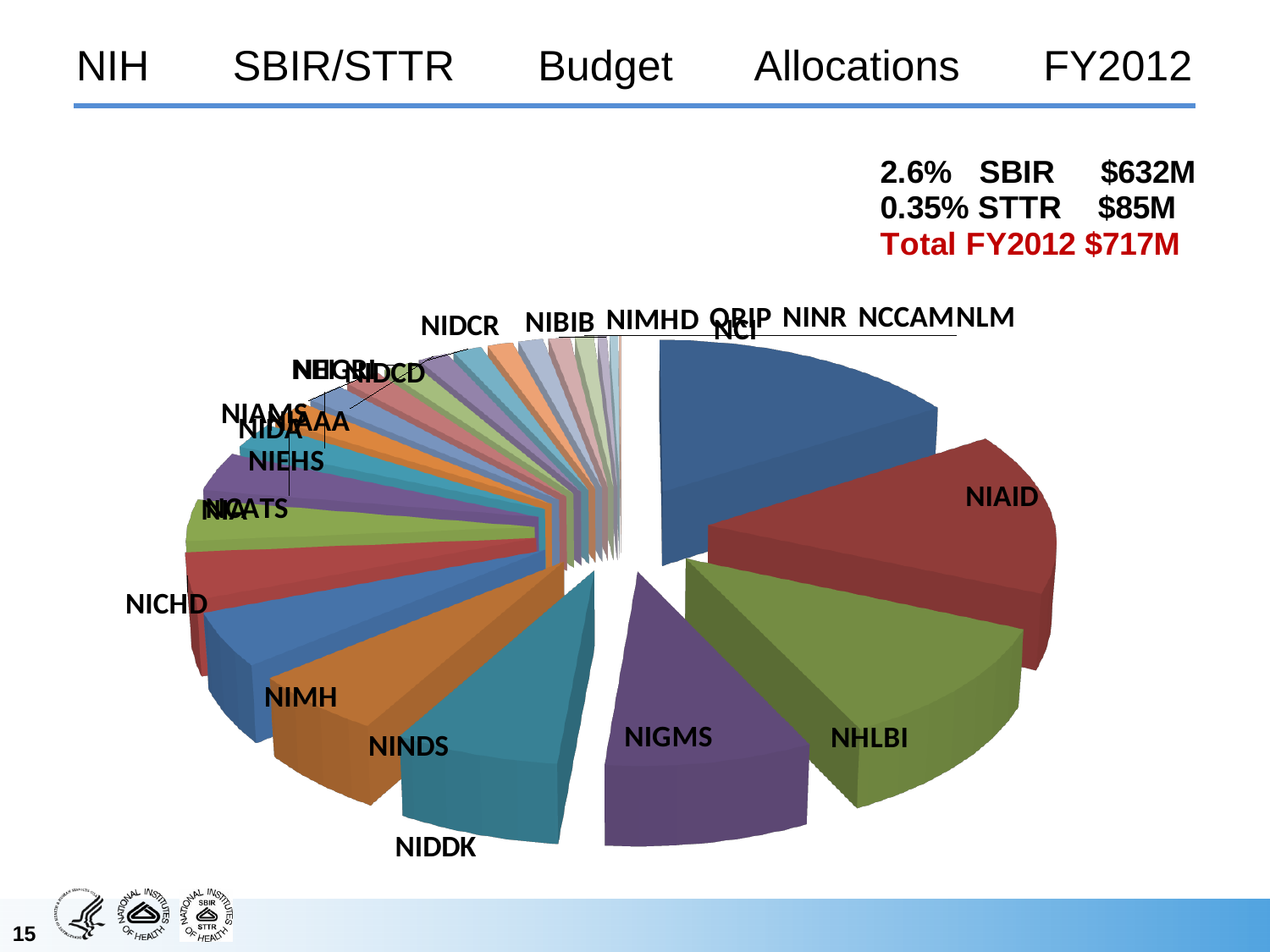
Which slice is larger, NHLBI or NINR? NHLBI What kind of chart is shown on the slide? pie chart According to the text beside the pie chart, what is the total FY2012 budget? $717M What is the title of the slide containing the pie chart? NIH SBIR/STTR Budget Allocations FY2012 Which slice is larger, NIAID or NIDCR? NIAID Which institute has the largest slice of the pie chart? NCI Which slice is larger, NCI or NLM? NCI